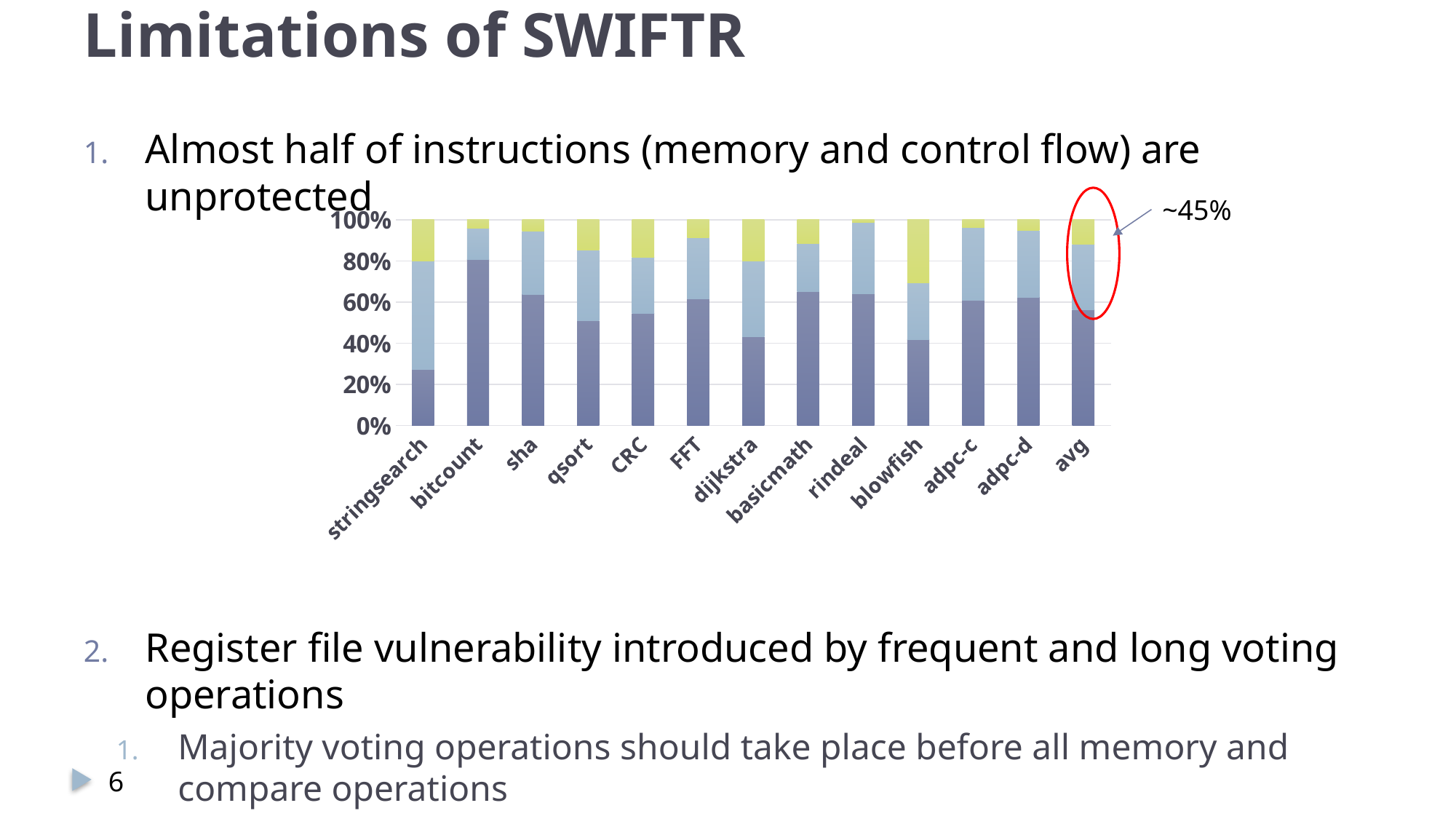
What kind of chart is shown on the slide? stacked bar chart Is the dark blue (bottom) segment for bitcount greater or less than 60%? greater Which has the larger dark blue (bottom) segment, bitcount or dijkstra? bitcount Which bar on the chart is circled in red? avg How many categories are shown along the x axis of the chart? 13 Which category has the largest yellow (top) segment? blowfish Is the dark blue (bottom) segment for blowfish greater or less than 60%? less Which category has the largest dark blue (bottom) segment? bitcount Is the dark blue (bottom) segment for stringsearch greater or less than 40%? less Which category has the smallest dark blue (bottom) segment? stringsearch What annotation text is written next to the red circle on the chart? ~45%